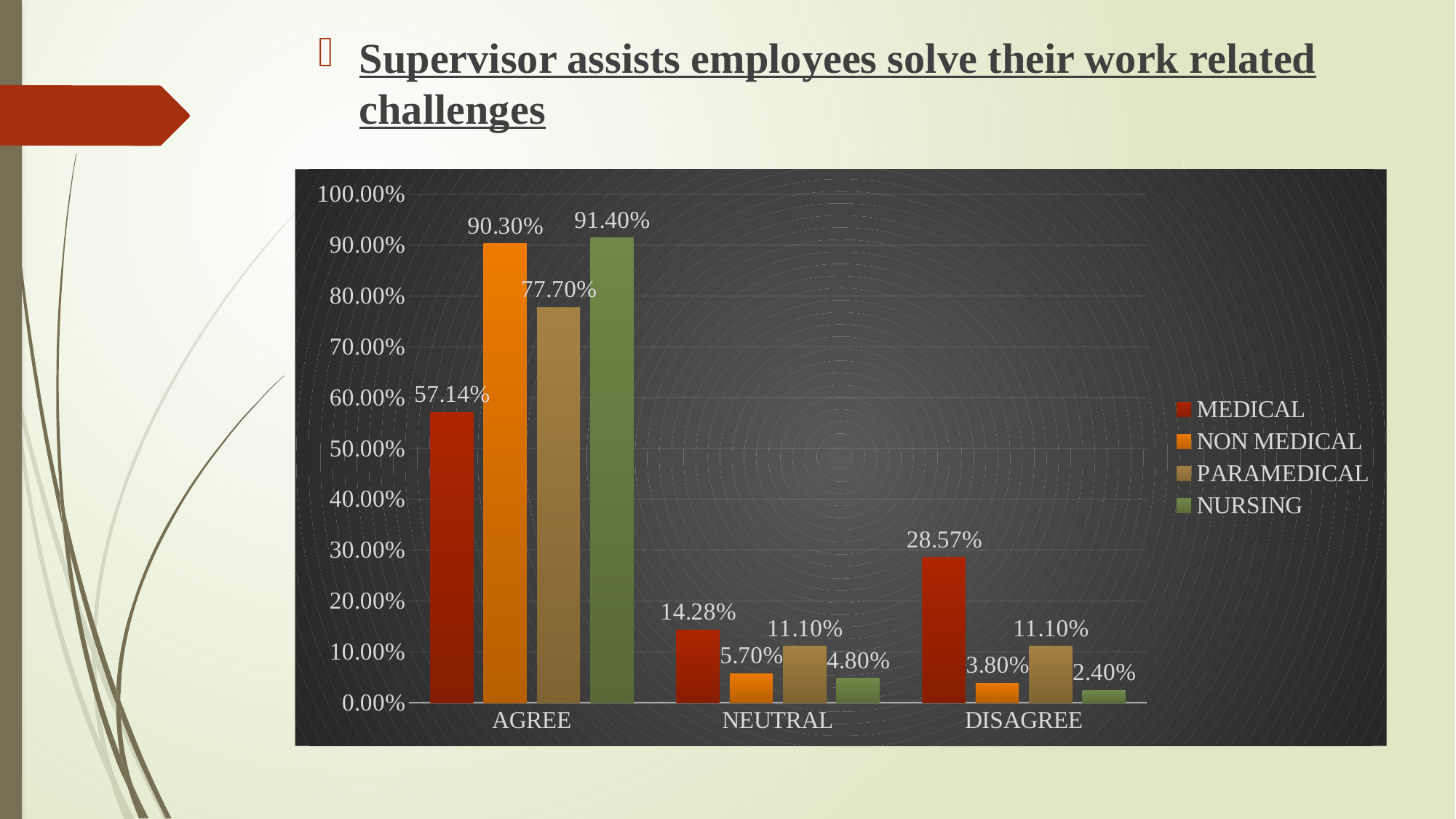
What is the difference between the NURSING and NON MEDICAL values in the AGREE category? 1.10% How many series does the legend list? 4 What is the value for PARAMEDICAL in the DISAGREE category? 11.10% Which series has the lowest value in the AGREE category? MEDICAL How many categories are shown on the x axis? 3 What colour represents the NON MEDICAL series in the legend? Orange What kind of chart is shown on the slide? Bar chart Which is larger in the NEUTRAL category: MEDICAL or PARAMEDICAL? MEDICAL Which series has the highest value in the DISAGREE category? MEDICAL What is the value for MEDICAL in the AGREE category? 57.14% What is the value for NON MEDICAL in the NEUTRAL category? 5.70% What is the value for NURSING in the AGREE category? 91.40%